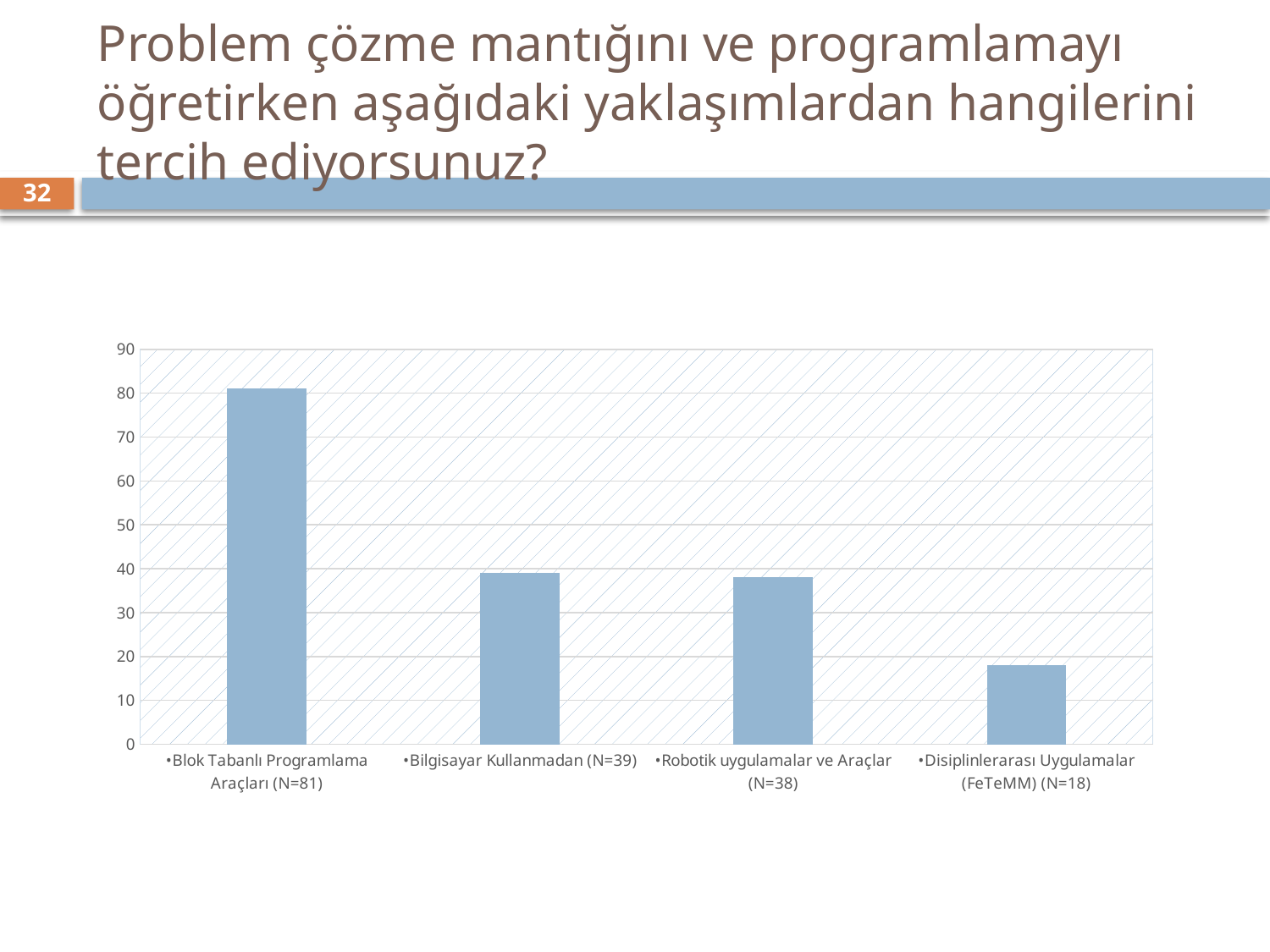
Is the value for Disiplinlerarası Uygulamalar (FeTeMM) greater or less than 30? less Which category has the lowest value in the chart? Disiplinlerarası Uygulamalar (FeTeMM) Which is larger, the value for Blok Tabanlı Programlama Araçları or the value for Robotik uygulamalar ve Araçlar? Blok Tabanlı Programlama Araçları What is the difference between the values for Blok Tabanlı Programlama Araçları and Bilgisayar Kullanmadan? 42 What kind of chart is shown on the slide? bar chart How many categories are shown in the chart? 4 What is the N value for Bilgisayar Kullanmadan? 39 What is the difference between the values for Blok Tabanlı Programlama Araçları and Disiplinlerarası Uygulamalar (FeTeMM)? 63 What is the N value for Disiplinlerarası Uygulamalar (FeTeMM)? 18 What is the highest value shown on the vertical axis of the chart? 90 Which category has the highest value in the chart? Blok Tabanlı Programlama Araçları What is the N value for Blok Tabanlı Programlama Araçları? 81